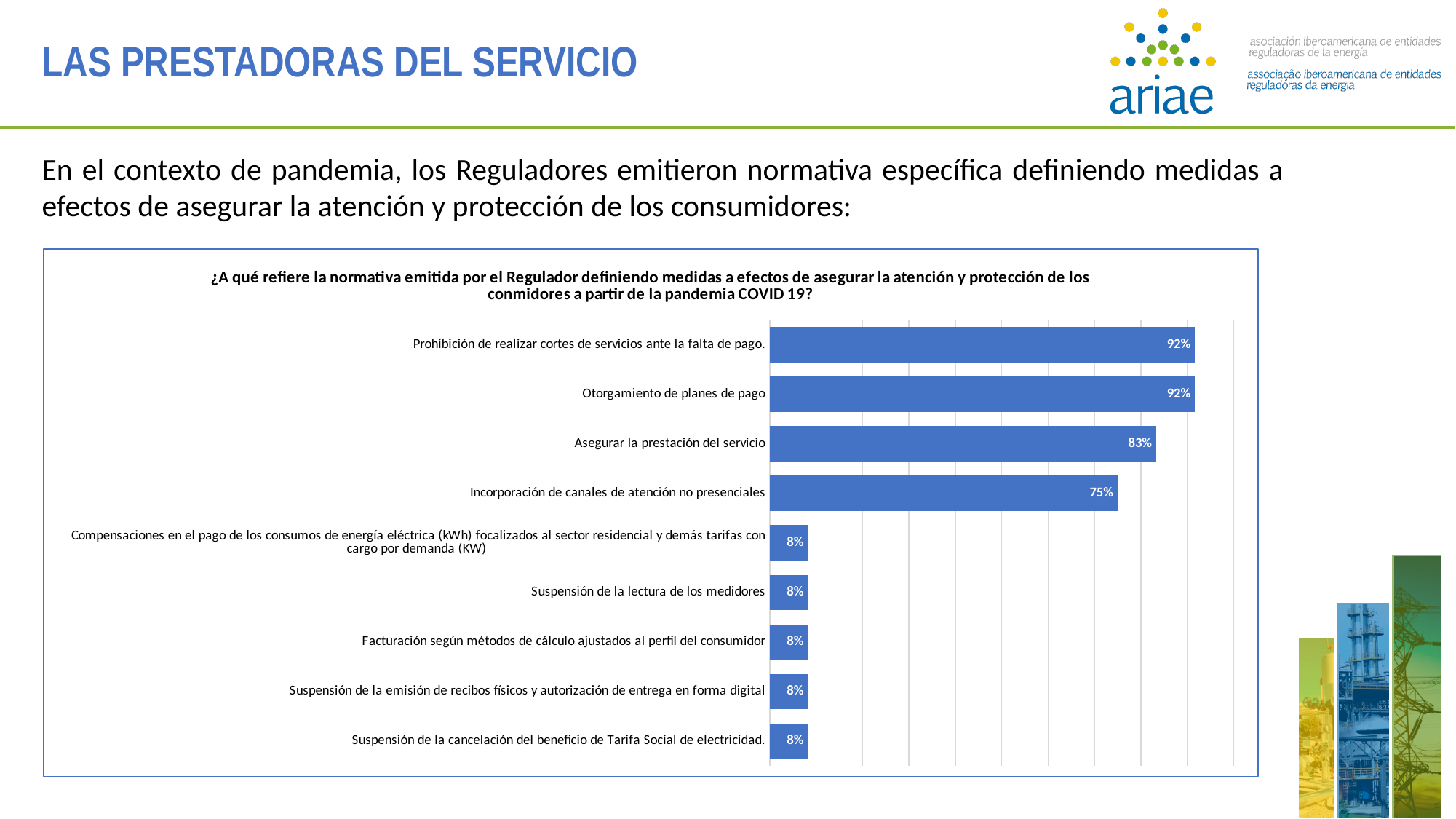
How many categories have a value of 8%? 5 What is the value for "Otorgamiento de planes de pago"? 92% What is the value for "Asegurar la prestación del servicio"? 83% What is the value for "Incorporación de canales de atención no presenciales"? 75% What is the difference between the values for "Otorgamiento de planes de pago" and "Suspensión de la lectura de los medidores"? 84% What is the value for "Suspensión de la lectura de los medidores"? 8% Which is larger, the value for "Asegurar la prestación del servicio" or the value for "Incorporación de canales de atención no presenciales"? Asegurar la prestación del servicio What is the difference between the values for "Asegurar la prestación del servicio" and "Incorporación de canales de atención no presenciales"? 8% How many categories are shown in the chart? 9 What colour are the bars in the chart? Blue What is the highest value shown in the chart? 92% What kind of chart is shown on the slide? Bar chart